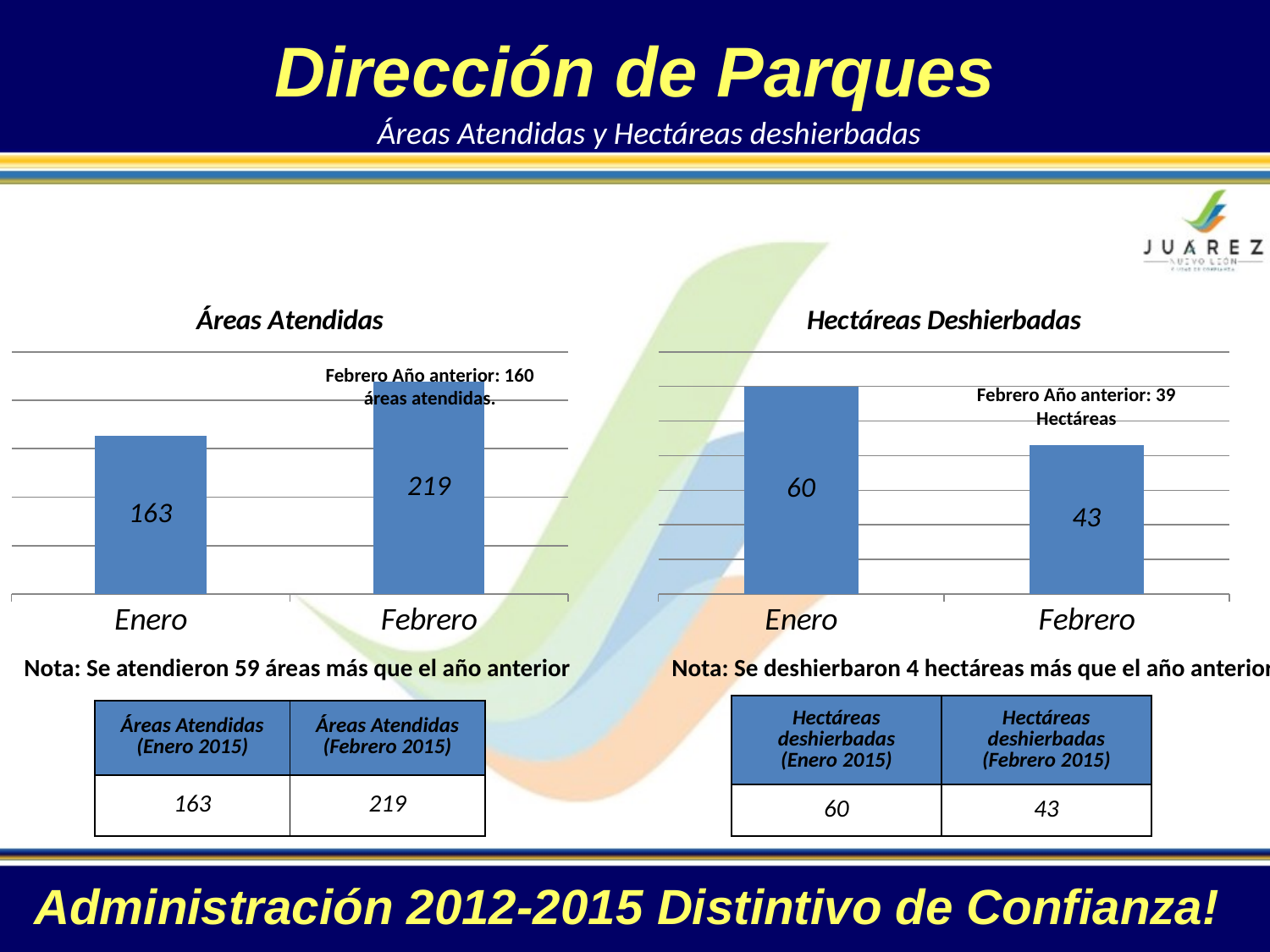
In the 'Áreas Atendidas' chart, which month has the higher value? Febrero In the 'Áreas Atendidas' chart, what is the value for Enero? 163 In the 'Áreas Atendidas' chart, do the values rise or fall from Enero to Febrero? rise In the 'Áreas Atendidas' chart, what is the difference between the Febrero and Enero values? 56 How many categories are shown in the 'Áreas Atendidas' chart? 2 In the 'Hectáreas Deshierbadas' chart, what is the value for Enero? 60 In the 'Áreas Atendidas' chart, what is the value for Febrero? 219 In the 'Hectáreas Deshierbadas' chart, which month has the lower value? Febrero What kind of chart is the 'Hectáreas Deshierbadas' chart? bar chart In the 'Hectáreas Deshierbadas' chart, is the value for Enero larger or smaller than the value for Febrero? larger In the 'Hectáreas Deshierbadas' chart, what is the value for Febrero? 43 In the 'Hectáreas Deshierbadas' chart, what is the difference between the Enero and Febrero values? 17